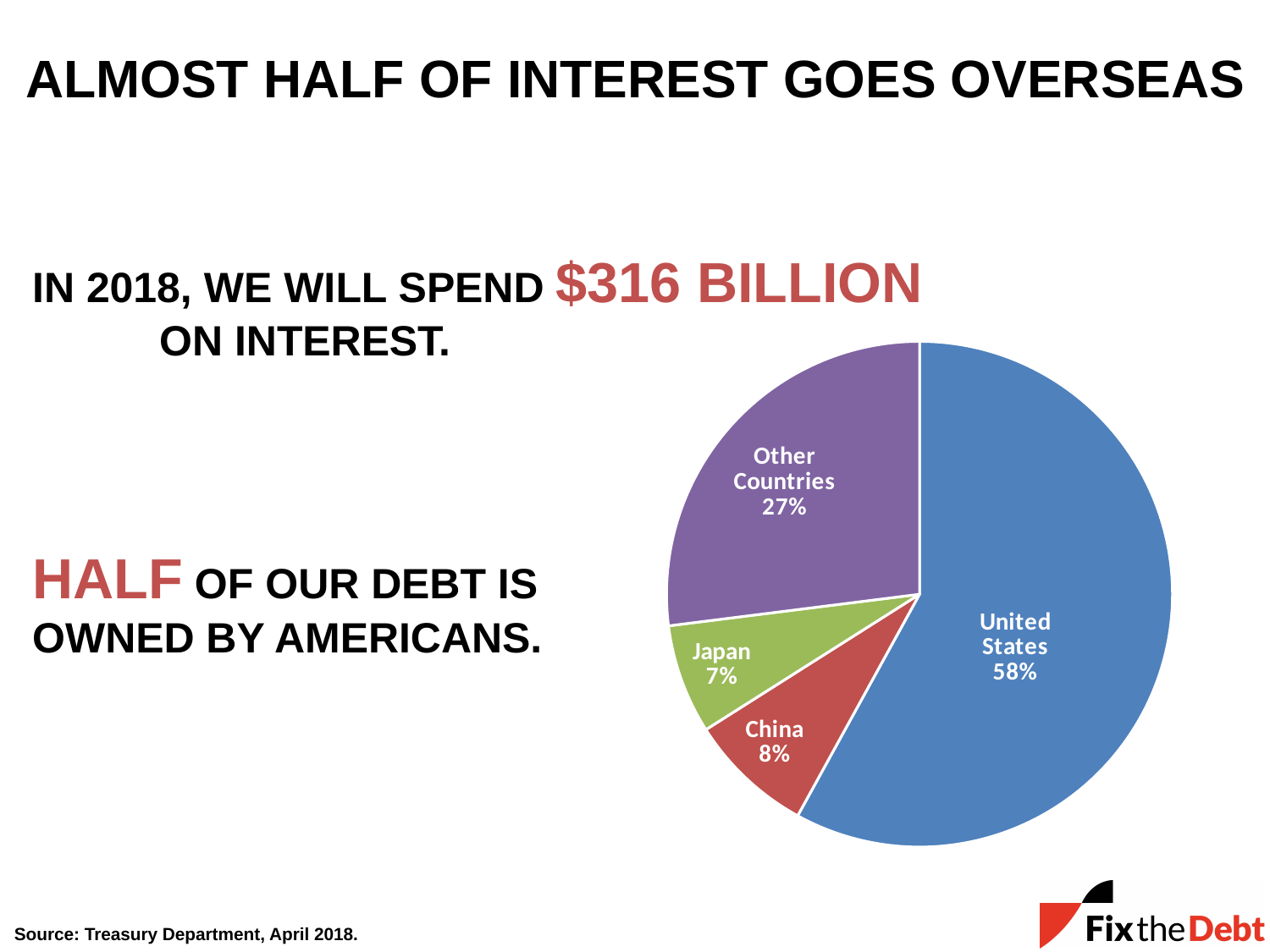
What is the combined share of China and Japan? 15% What share of the pie does the United States hold? 58% What percentage is shown for Japan? 7% What colour is the United States slice? Blue What type of chart is shown on the slide? Pie chart Which is larger, the share for China or the share for Japan? China Which slice of the pie is the smallest? Japan How many slices does the pie chart have? 4 Which slice of the pie is the largest? United States What is the difference in percentage points between the United States and Other Countries? 31 What percentage is shown for Other Countries? 27% What percentage is shown for China? 8%